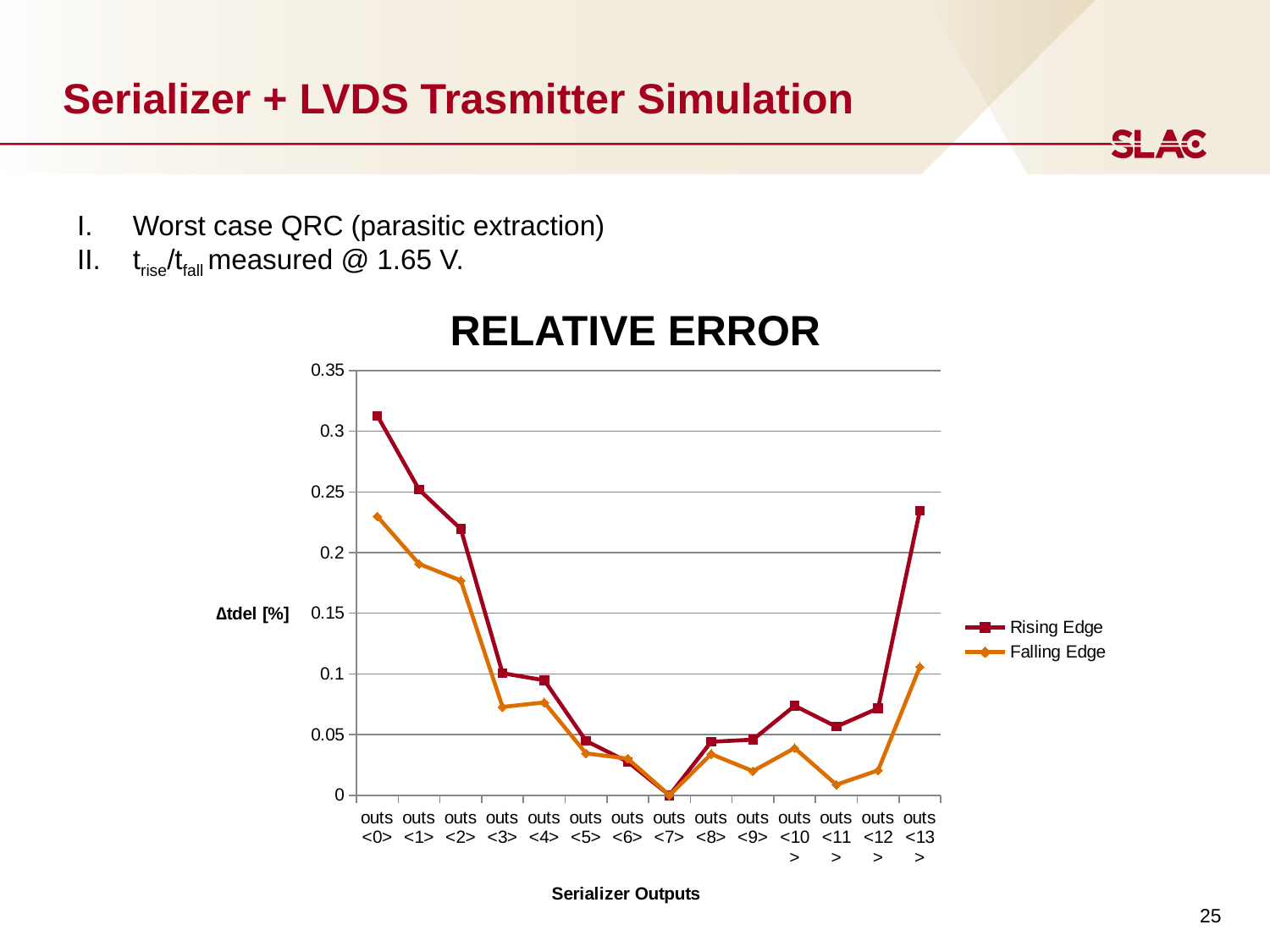
Which serializer output has the highest Rising Edge value? outs<0> What is the title of the chart? RELATIVE ERROR How many series does the legend list? 2 For the Rising Edge series, which is larger: the value at outs<0> or the value at outs<13>? outs<0> How many serializer outputs are plotted along the x axis? 14 What kind of chart is shown on the slide? line chart Is the Falling Edge value for outs<2> greater or less than 0.2? less Is the Rising Edge value for outs<13> greater or less than 0.2? greater Which serializer output has the lowest Falling Edge value? outs<7> At outs<1>, which series has the larger value, Rising Edge or Falling Edge? Rising Edge Is the Rising Edge value for outs<0> greater or less than 0.3? greater Do the Rising Edge values rise or fall from outs<0> to outs<7>? fall